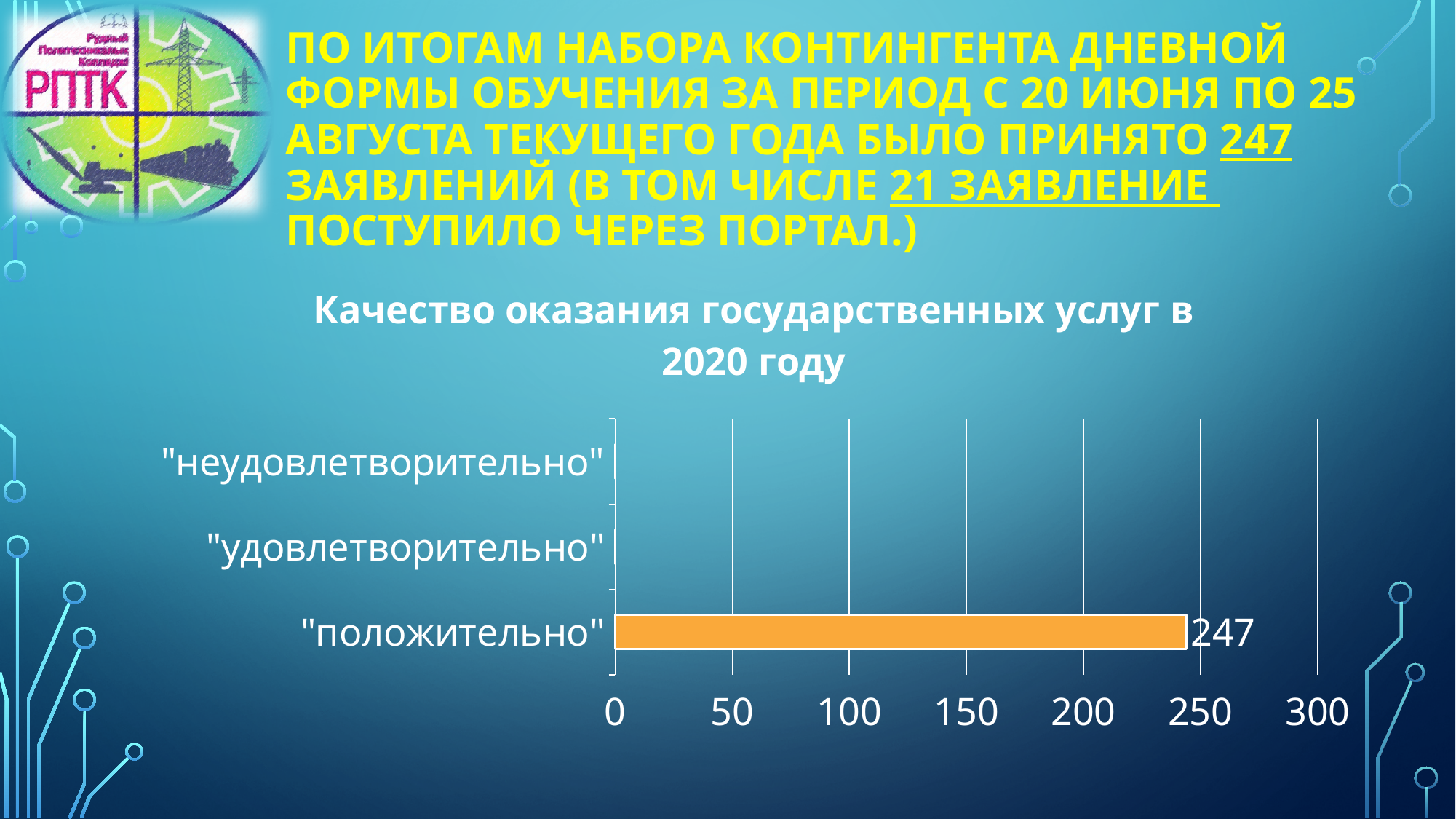
Is the value for "положительно" greater or less than 250? less What is the value for "положительно" in the chart? 247 What is the highest tick value shown on the chart's horizontal axis? 300 Is the value for "положительно" greater or less than 200? greater How many categories are shown on the chart's vertical axis? 3 Which category has the highest value in the chart? "положительно" Which is larger, the value for "положительно" or the value for "удовлетворительно"? "положительно" What is the title of the chart? Качество оказания государственных услуг в 2020 году Which is larger, the value for "положительно" or the value for "неудовлетворительно"? "положительно" What kind of chart is shown on the slide? bar chart